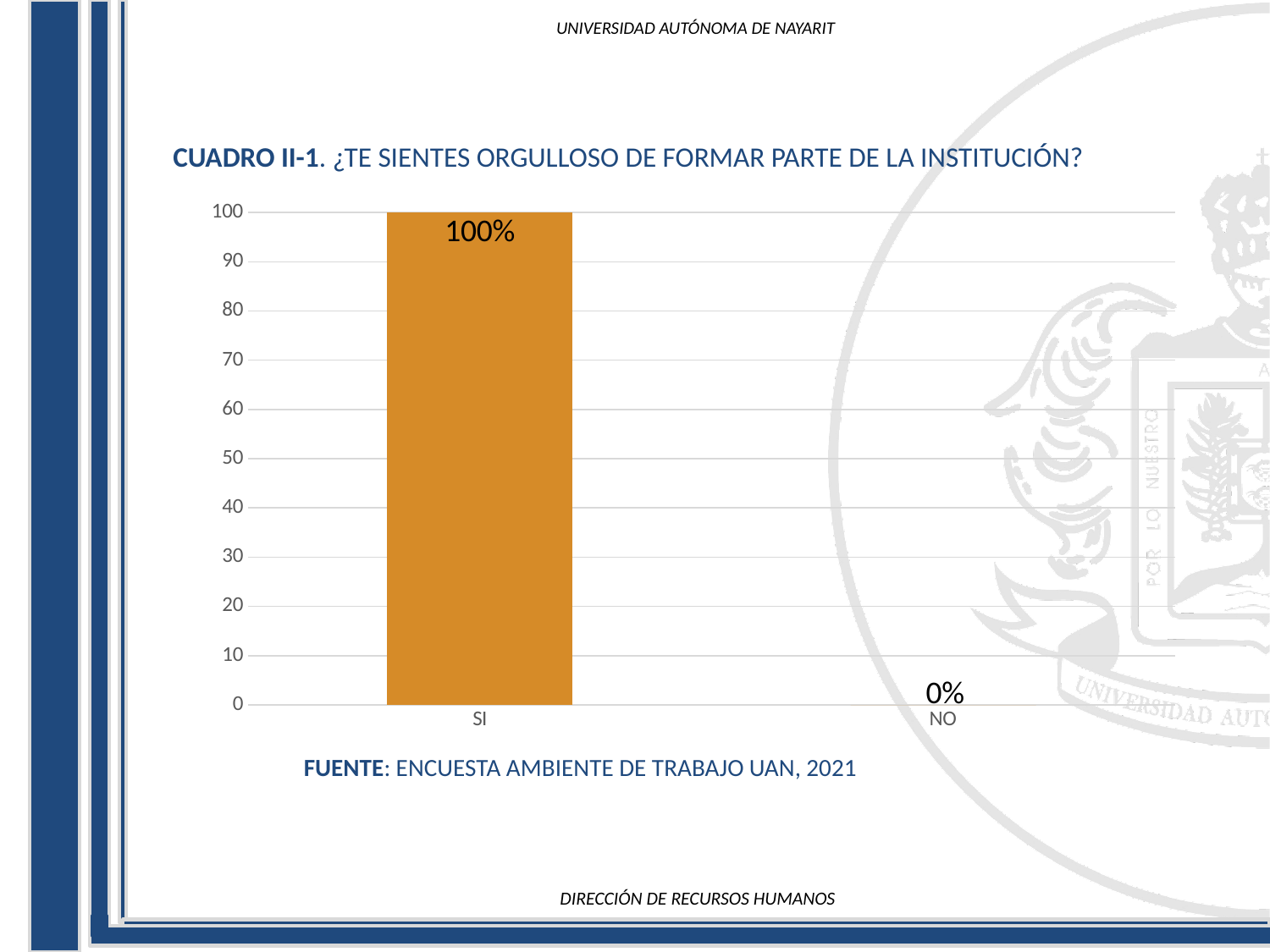
Which is larger, the value for SI or the value for NO? SI What is the title of the chart? CUADRO II-1. ¿TE SIENTES ORGULLOSO DE FORMAR PARTE DE LA INSTITUCIÓN? What is the value for SI? 100% Which category has the highest value? SI What kind of chart is shown on the slide? bar chart What is the difference between the values for SI and NO? 100% Is the value for SI greater or less than 50? greater What is the value for NO? 0% Which category has the lowest value? NO What is the total of the values for SI and NO? 100% What is the source cited below the chart? ENCUESTA AMBIENTE DE TRABAJO UAN, 2021 How many categories are shown on the x axis? 2